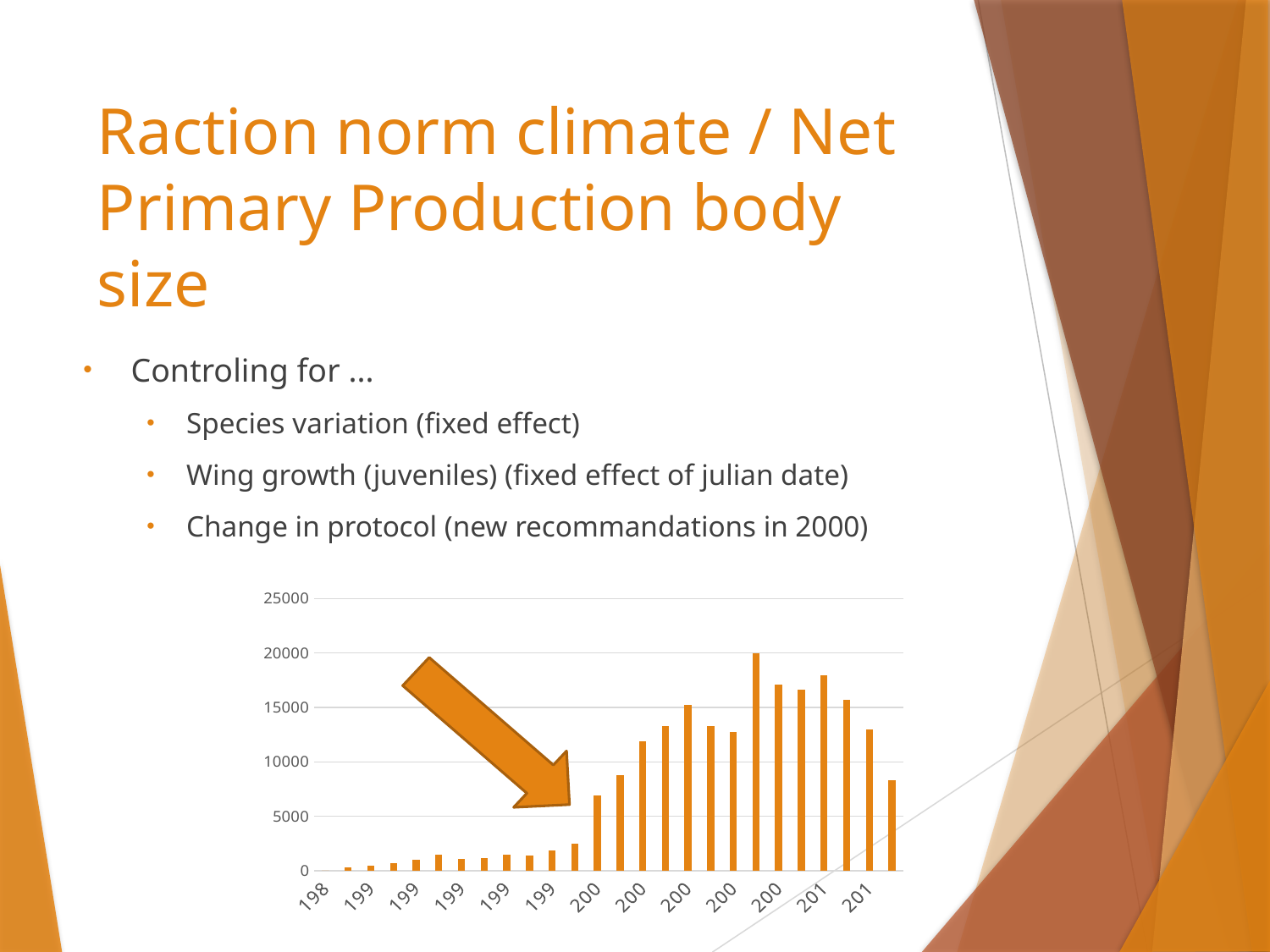
Do the bars in the left half of the chart generally rise or fall moving from left to right? rise Is the rightmost bar taller or shorter than the tallest bar in the chart? shorter Is the value of the tallest bar in the chart greater or less than 15000? greater Is the value of the tallest bar in the chart greater or less than 25000? less Is the leftmost bar taller or shorter than the rightmost bar in the chart? shorter Is the value of the rightmost bar in the chart greater or less than 10000? less What is the highest value shown on the y axis of the chart? 25000 What kind of chart is shown on the slide? bar chart What colour are the bars in the chart? orange